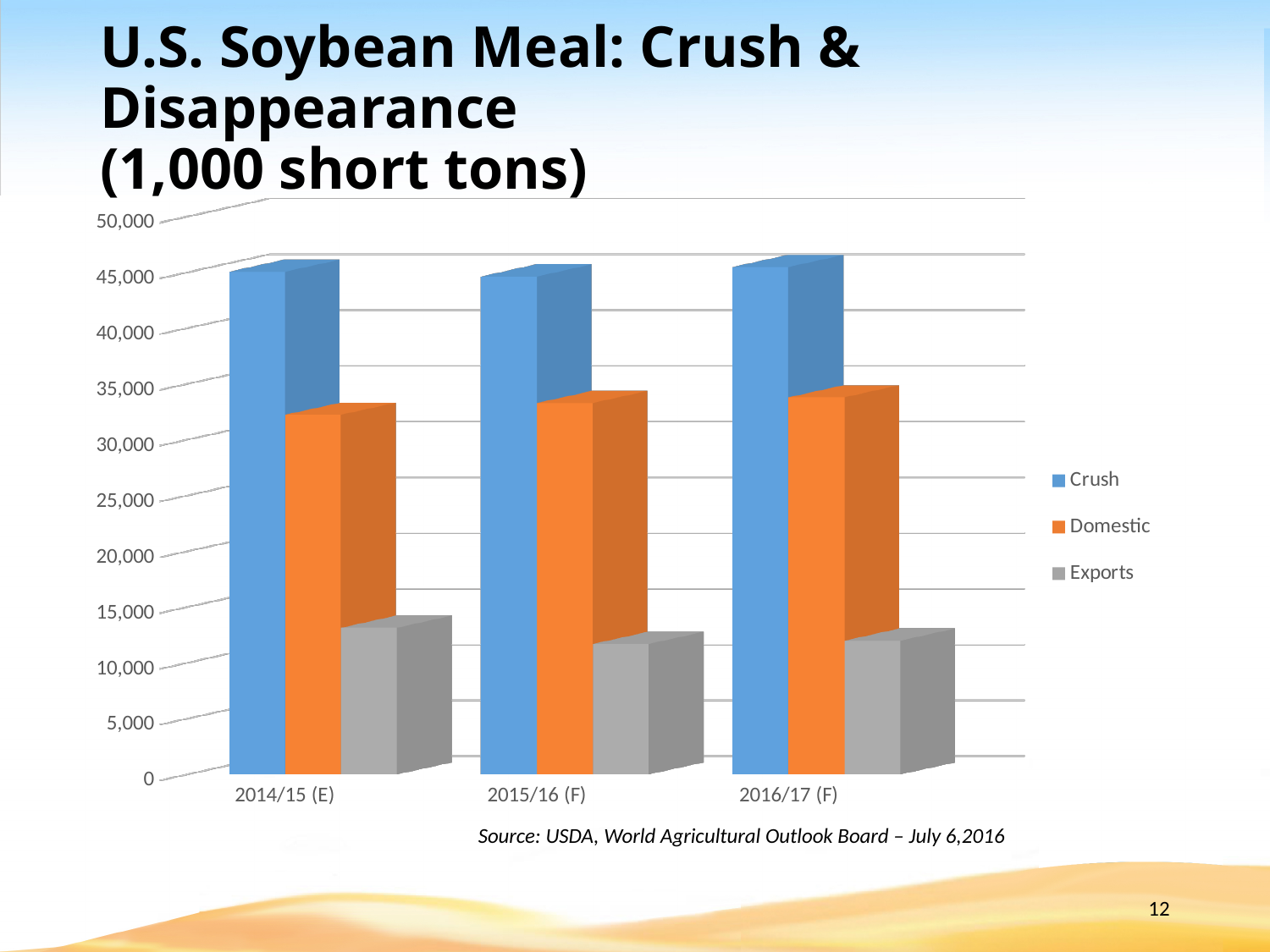
How many series does the legend list? 3 Is the Exports value for 2015/16 (F) greater or less than 10,000? greater Which year has the larger Exports value, 2014/15 (E) or 2015/16 (F)? 2014/15 (E) Which series has the highest value in 2014/15 (E)? Crush What kind of chart is shown on the slide? bar chart How many marketing-year categories are shown on the x axis? 3 Is the Domestic value for 2016/17 (F) greater or less than 30,000? greater Is the Crush value for 2015/16 (F) greater or less than 40,000? greater Which is larger in 2016/17 (F), Domestic or Exports? Domestic What is the unit stated in the chart title? 1,000 short tons Which series has the lowest value in 2016/17 (F)? Exports